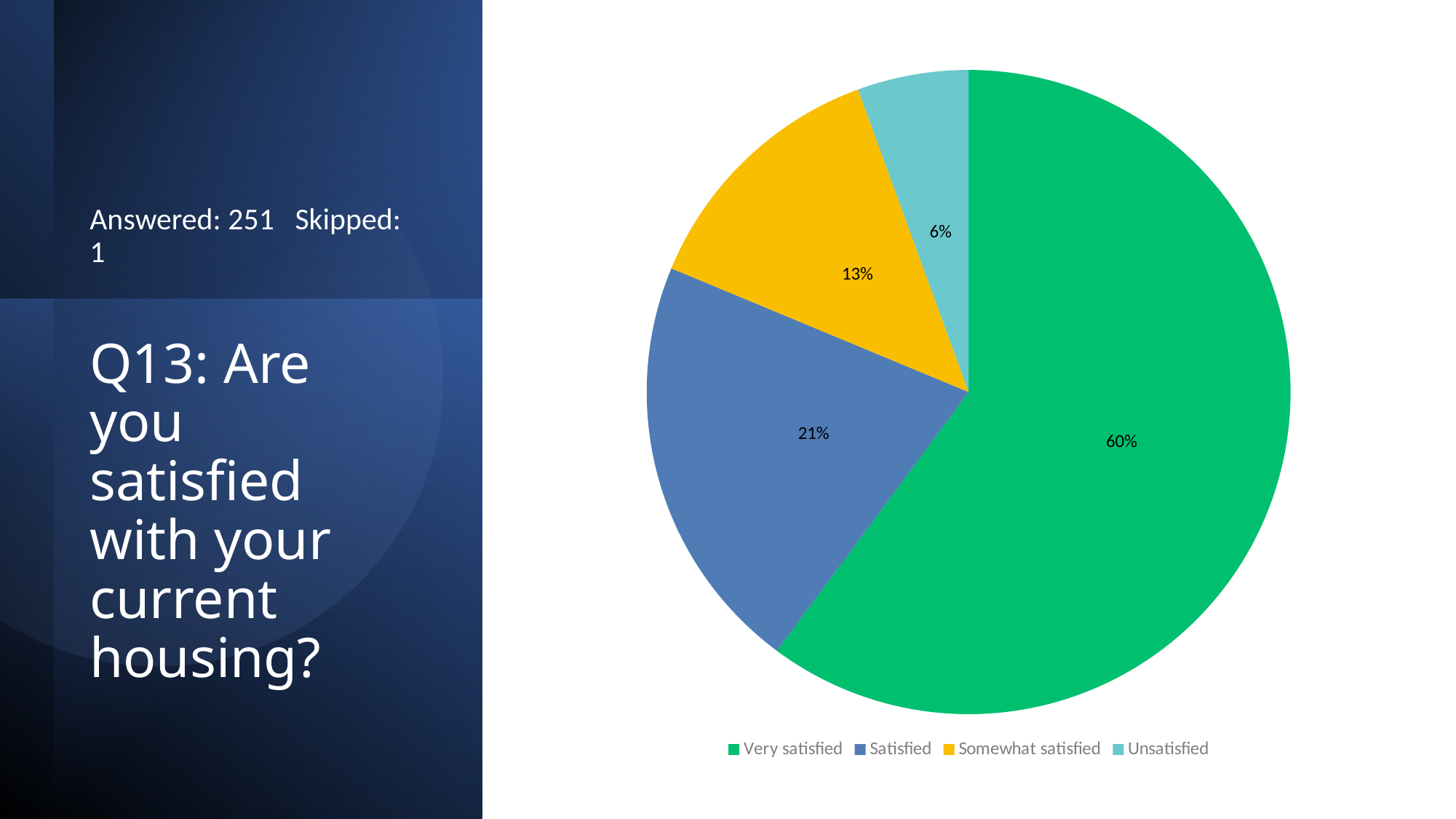
Which category has the largest slice of the pie? Very satisfied What share of the pie is labelled "Unsatisfied"? 6% Which slice is larger, "Somewhat satisfied" or "Unsatisfied"? Somewhat satisfied What kind of chart is shown on the slide? pie chart What share of the pie is labelled "Somewhat satisfied"? 13% What share of the pie is labelled "Satisfied"? 21% What colour is the "Somewhat satisfied" slice? yellow What is the difference in percentage points between the "Very satisfied" and "Satisfied" slices? 39 How many respondents answered the question according to the slide? 251 How many categories does the legend list? 4 Which category has the smallest slice of the pie? Unsatisfied